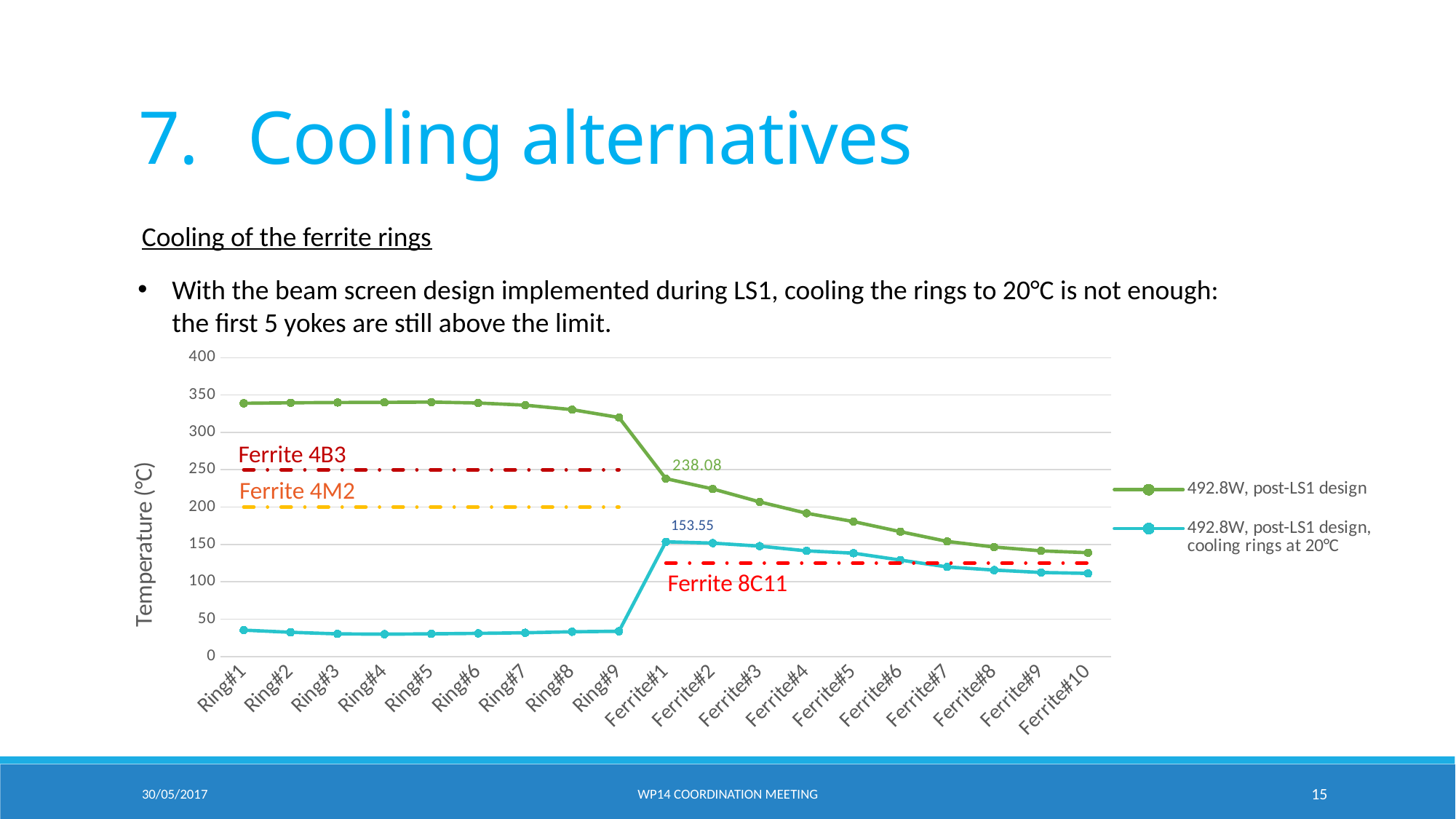
What kind of chart is shown on the slide? Line chart How many categories are plotted along the x axis? 19 Does the "492.8W, post-LS1 design" series rise or fall from Ferrite#1 to Ferrite#10? Fall At Ferrite#1, which series has the higher value? 492.8W, post-LS1 design What is the value of the "492.8W, post-LS1 design" series at Ferrite#1? 238.08 How many series does the legend list? 2 Which category has the highest value for the "492.8W, post-LS1 design, cooling rings at 20°C" series? Ferrite#1 Is the value of the "492.8W, post-LS1 design" series at Ring#1 greater or less than 300? greater Is the value of the "492.8W, post-LS1 design, cooling rings at 20°C" series at Ring#5 greater or less than 50? less What is the title of the vertical axis? Temperature (°C) At Ferrite#1, what is the difference between the "492.8W, post-LS1 design" value and the "492.8W, post-LS1 design, cooling rings at 20°C" value? 84.53 What is the value of the "492.8W, post-LS1 design, cooling rings at 20°C" series at Ferrite#1? 153.55